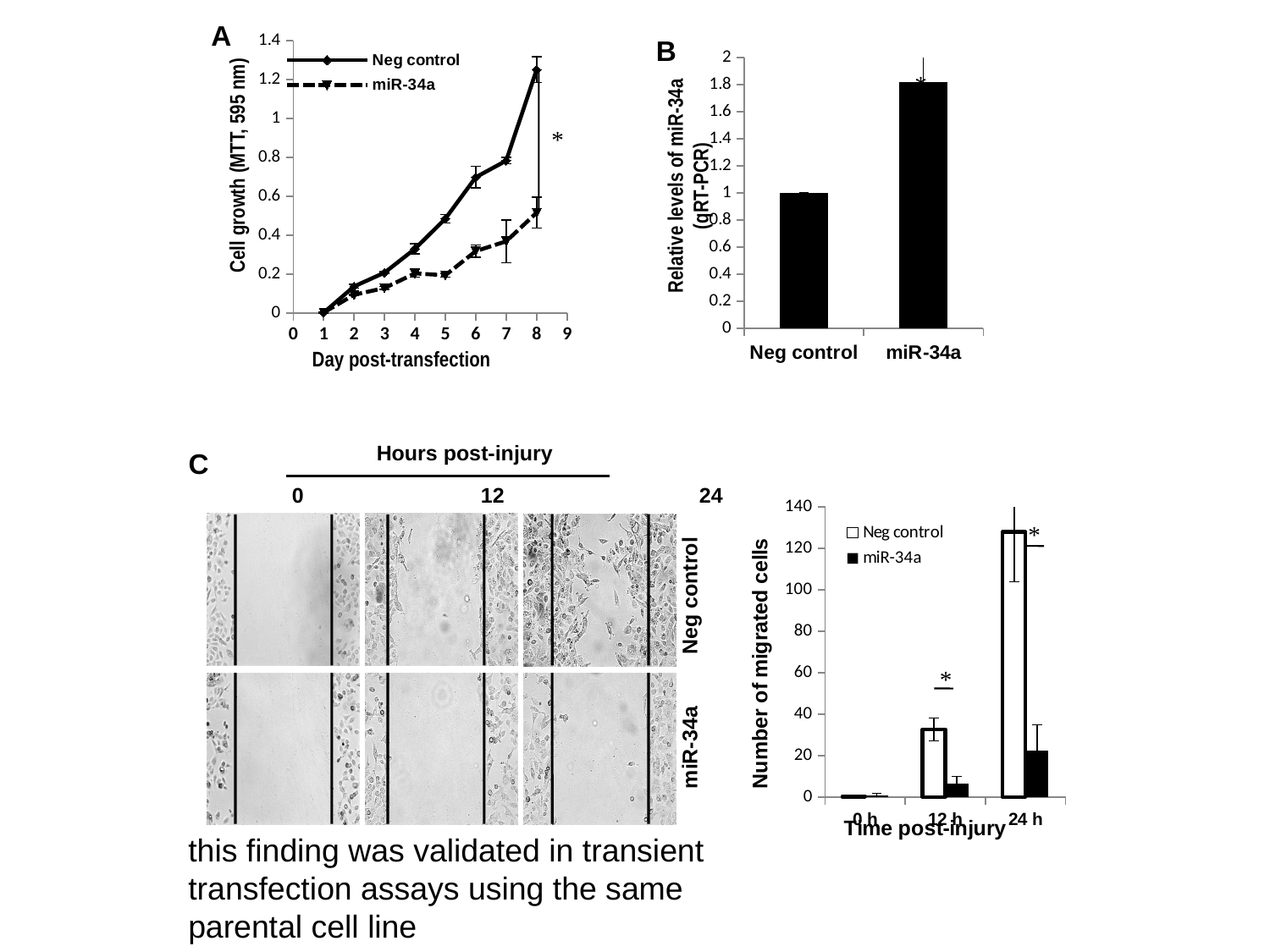
In chart C (Number of migrated cells), is the Neg control value at 24 h greater or less than 120? greater In chart A (Cell growth), is the Neg control value at day 8 greater or less than 1? greater In chart B (Relative levels of miR-34a), which category has the highest value? miR-34a In chart B (Relative levels of miR-34a), is the value for miR-34a greater or less than 1.6? greater In chart A (Cell growth), how many series does the legend list? 2 In chart A (Cell growth), which series has the higher value at day 8, Neg control or miR-34a? Neg control In chart A (Cell growth), what kind of chart is shown? line chart In chart A (Cell growth), do the Neg control values rise or fall from day 1 to day 8? rise In chart B (Relative levels of miR-34a), what is the value for Neg control? 1 In chart C (Number of migrated cells), how many time-point categories are shown on the x axis? 3